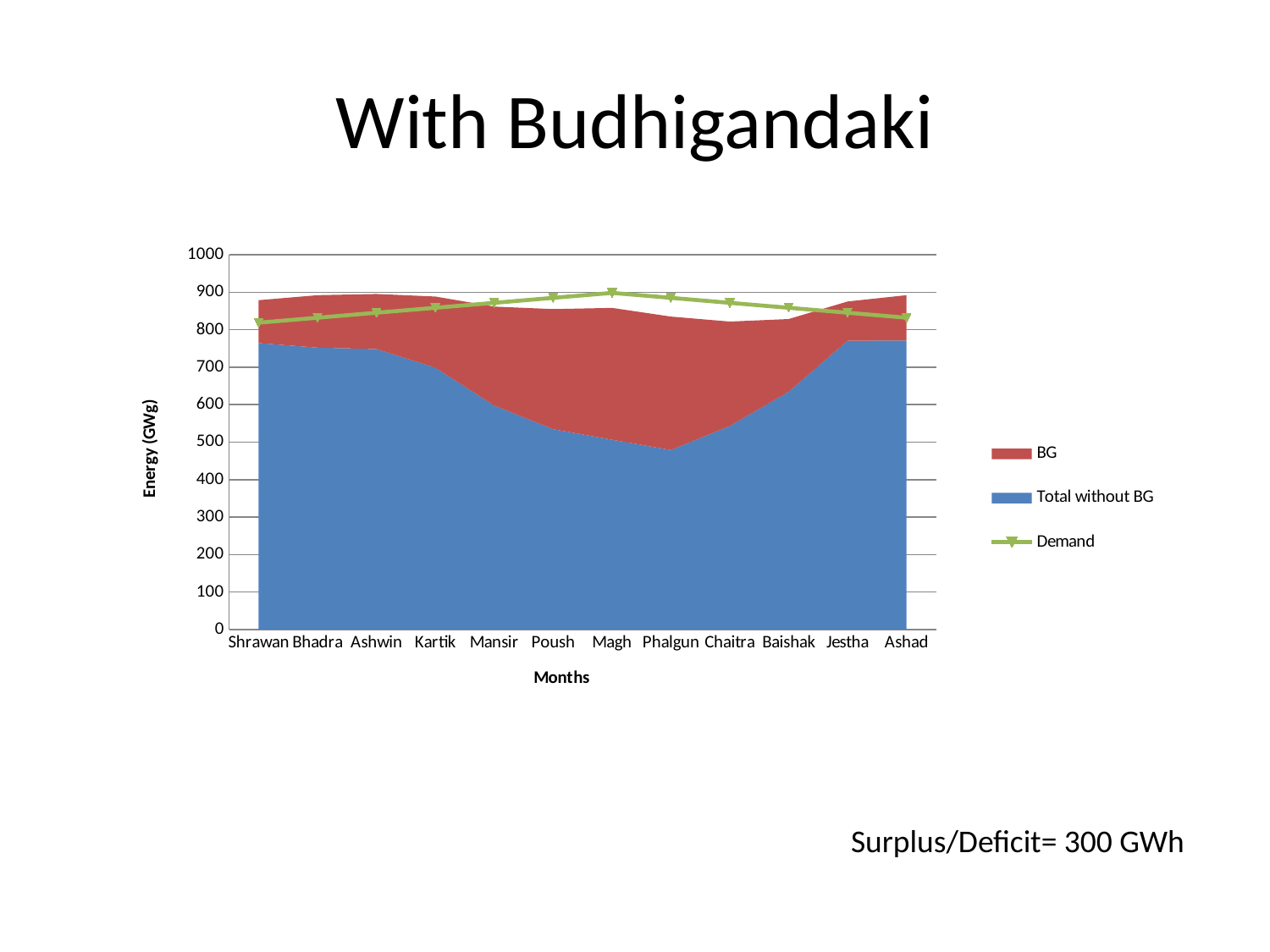
Is the value for Total without BG in Phalgun greater or less than 500? less What is the label on the vertical axis of the chart? Energy (GWg) Is the Demand value in Kartik greater or less than 900? less Which is larger, Total without BG in Kartik or Total without BG in Poush? Kartik How many series does the chart legend list? 3 In which month does the Demand line reach its highest point? Magh What kind of chart is shown on the slide? combination area and line chart Does the Total without BG area rise or fall from Shrawan to Phalgun? fall How many months are shown on the x axis of the chart? 12 Is the value for Total without BG in Shrawan greater or less than 700? greater What is the title of the slide containing the chart? With Budhigandaki Which month has the lowest value for Total without BG? Phalgun